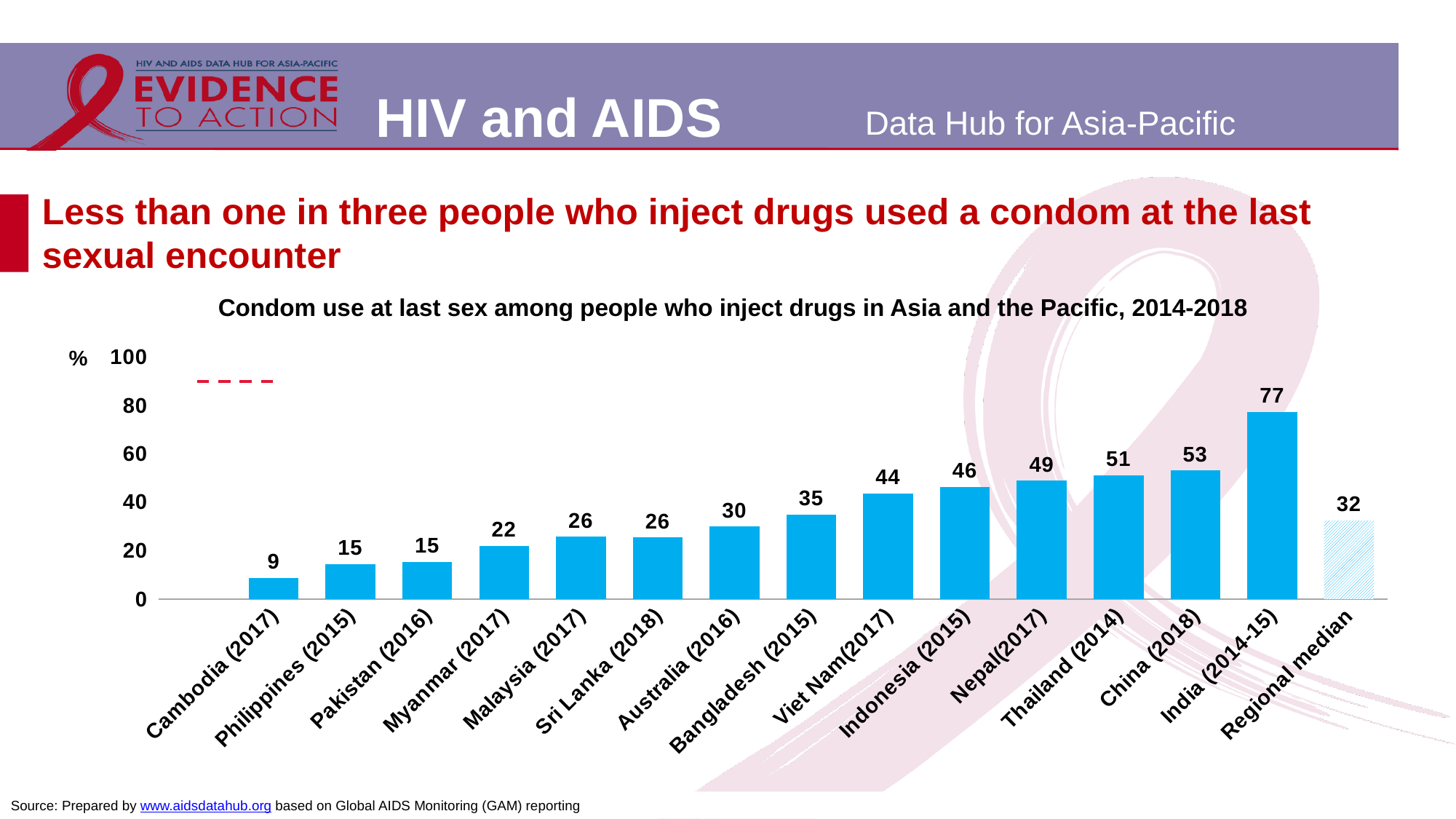
What is the value for Cambodia (2017)? 9 What is the value for India (2014-15)? 77 What is the value for Viet Nam (2017)? 44 Which category has the lowest value? Cambodia (2017) How many categories are shown on the x axis? 15 What kind of chart is this? Bar chart Which is larger, the value for Thailand (2014) or the value for Nepal (2017)? Thailand (2014) Which category has the highest value? India (2014-15) What is the title of the chart? Condom use at last sex among people who inject drugs in Asia and the Pacific, 2014-2018 What is the difference between the values for India (2014-15) and China (2018)? 24 What is the value for the Regional median? 32 Do the values generally rise or fall from Cambodia (2017) to India (2014-15) along the x axis? Rise